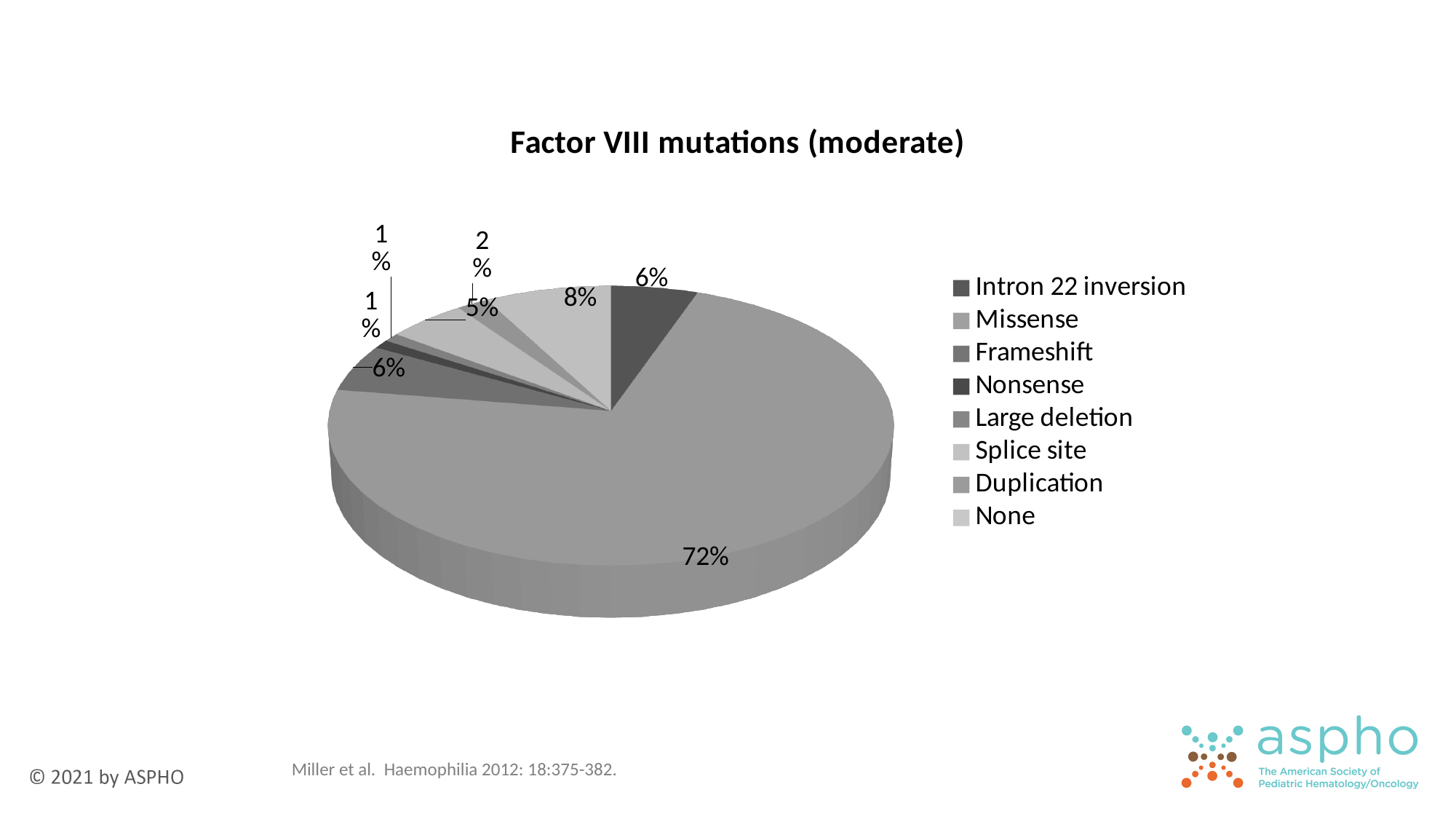
What percentage is shown for Splice site? 5% What share of the pie does Missense account for? 72% Which category has the largest slice of the pie? Missense What percentage is shown for Duplication? 2% What is the title of the chart? Factor VIII mutations (moderate) What type of chart is shown on the slide? pie chart Is the share for Missense greater or less than 50%? greater Which is larger, the share for None or the share for Duplication? None What is the difference in percentage points between Missense and None? 64 How many categories does the legend of the pie chart list? 8 What percentage is shown for the None category? 8% What percentage is shown for Intron 22 inversion? 6%